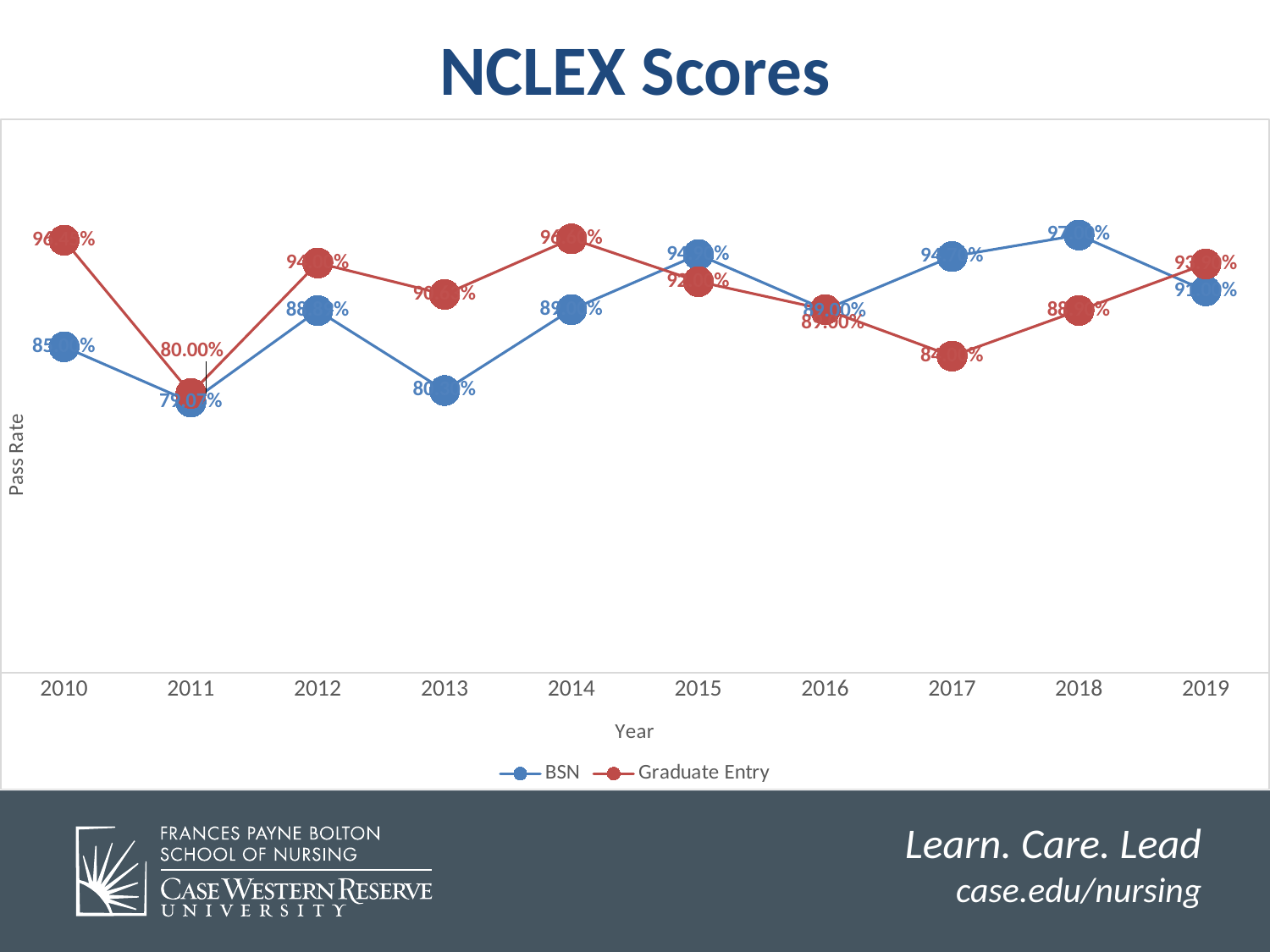
What kind of chart is shown on the slide? line chart Does the BSN pass rate rise or fall from 2016 to 2018? rise In which year is the BSN pass rate lowest? 2011 How many series does the legend list? 2 What is the Graduate Entry pass rate in 2016? 89.00% In which year is the Graduate Entry pass rate lowest? 2011 What is the Graduate Entry pass rate in 2011? 80.00% What is the title of the chart? NCLEX Scores In 2018, which series has the higher pass rate, BSN or Graduate Entry? BSN What is the BSN pass rate in 2011? 79.07% How many years are plotted along the x axis? 10 What is the label on the vertical axis? Pass Rate